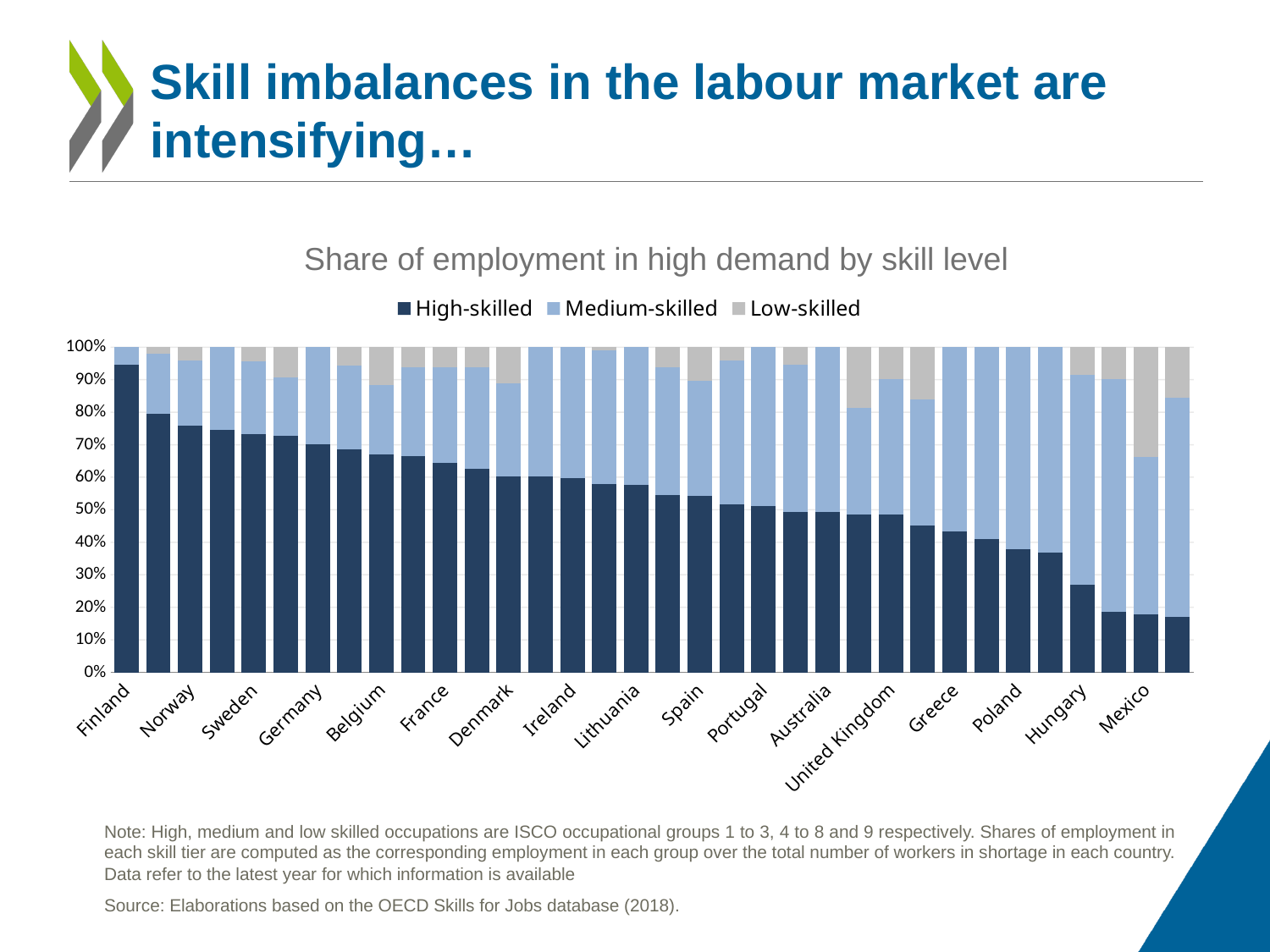
How many series does the legend list? 3 What is the title of the chart? Share of employment in high demand by skill level Is the High-skilled share for Belgium greater or less than 70%? less What kind of chart is shown on the slide? Stacked bar chart Is the High-skilled share for Finland greater or less than 90%? greater Which has the larger High-skilled share, Hungary or Mexico? Hungary Is the High-skilled share for Greece greater or less than 50%? less Do the High-skilled shares rise or fall from left to right across the countries? fall Which country has the highest High-skilled share? Finland